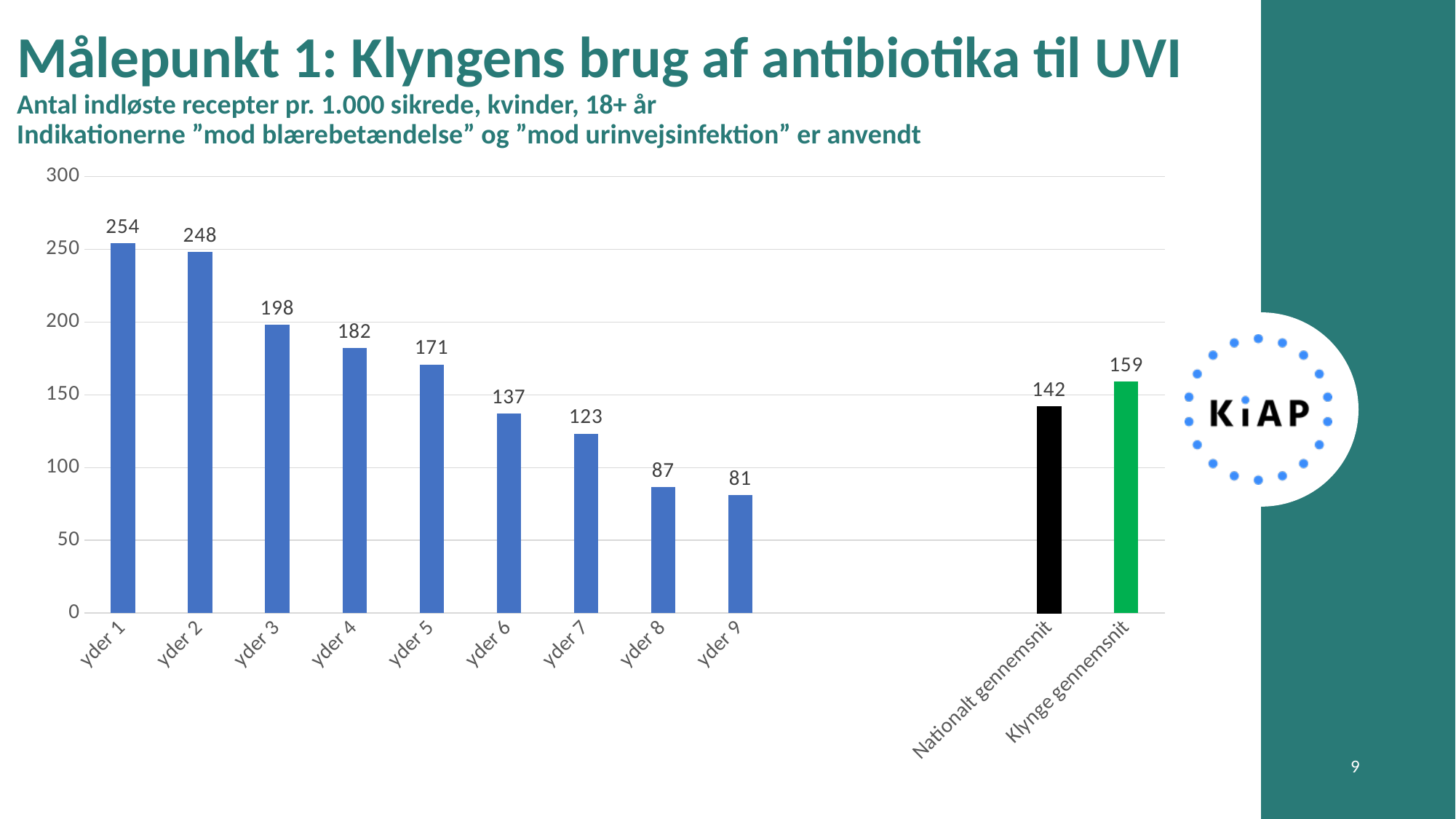
What is the difference between the values for yder 1 and yder 9? 173 Which yder has the highest value? yder 1 How many bars are plotted in the chart? 11 Which is larger, the value for yder 5 or the value for yder 6? yder 5 What is the value for Nationalt gennemsnit? 142 Which yder has the lowest value? yder 9 Do the values rise or fall from yder 1 to yder 9? fall What is the value for Klynge gennemsnit? 159 What is the difference between Klynge gennemsnit and Nationalt gennemsnit? 17 Is the value for yder 7 greater or less than 100? greater What is the value for yder 1? 254 What kind of chart is shown on the slide? bar chart